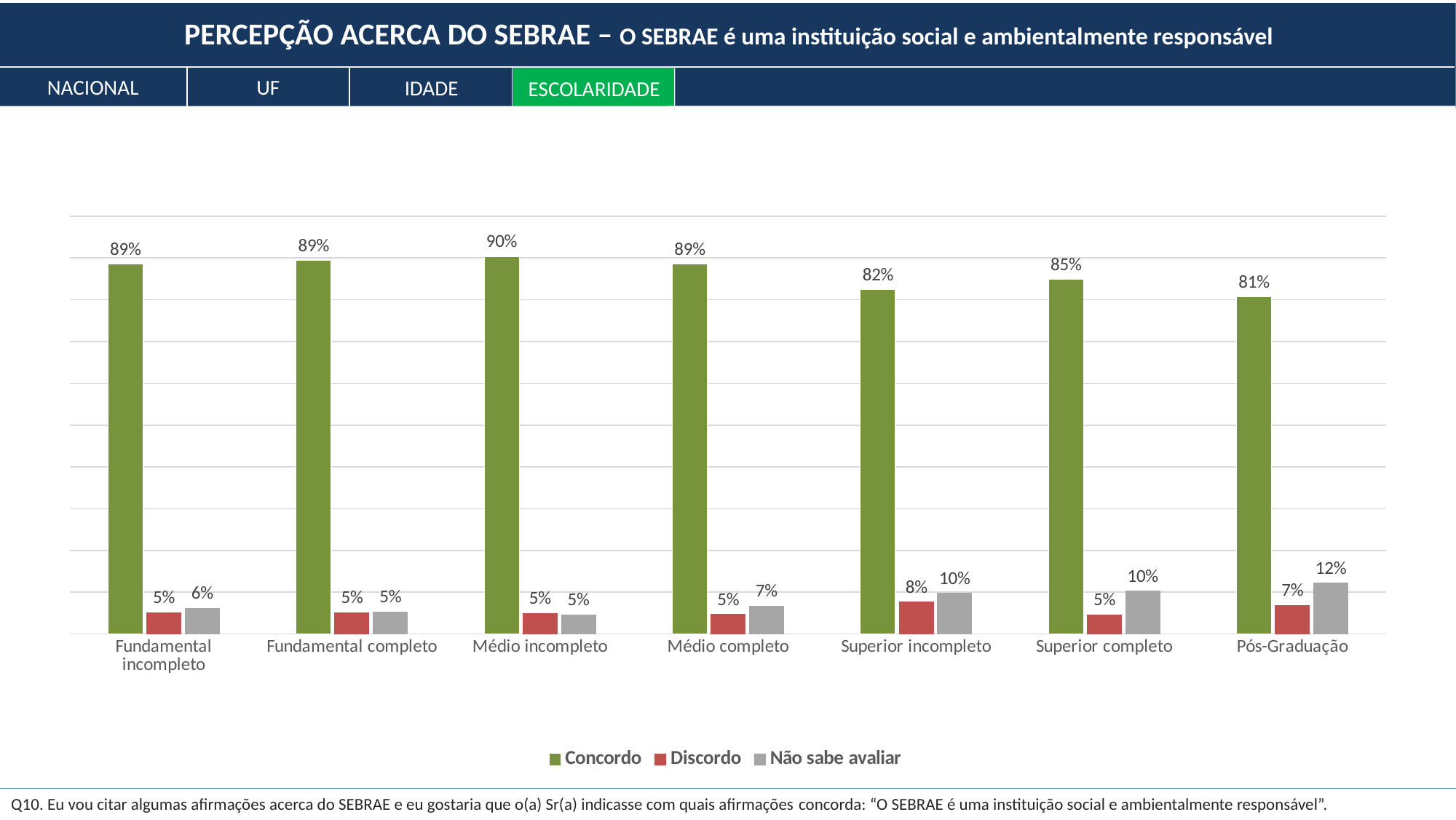
What is the difference between the Concordo values for Médio incompleto and Pós-Graduação? 9 percentage points Which is larger, the Não sabe avaliar value for Superior completo or for Médio completo? Superior completo How many education levels are shown on the x axis? 7 Which education level has the lowest Concordo value? Pós-Graduação What kind of chart is shown on the slide? Bar chart Which tab is highlighted in green above the chart? ESCOLARIDADE Which education level has the highest Concordo value? Médio incompleto What is the Concordo value for Médio incompleto? 90% What is the Não sabe avaliar value for Pós-Graduação? 12% What is the Discordo value for Superior incompleto? 8% How many series does the legend list? 3 What is the total of Concordo, Discordo and Não sabe avaliar for Superior incompleto? 100%